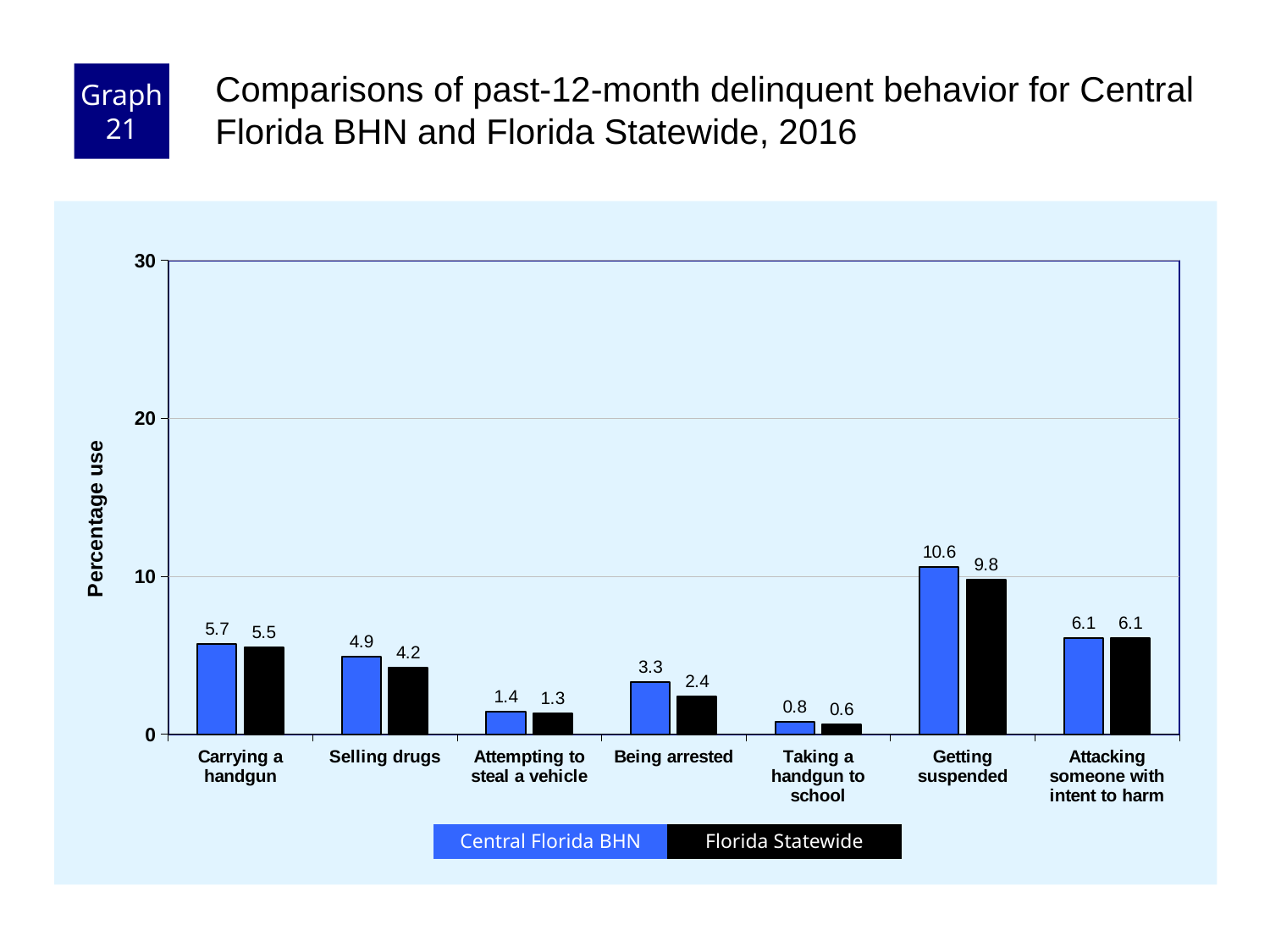
How many categories are shown on the x axis? 7 Which category has the highest Florida Statewide value? Getting suspended What is the Florida Statewide value for Being arrested? 2.4 How many series does the legend list? 2 What is the Central Florida BHN value for Taking a handgun to school? 0.8 Which category has the lowest Central Florida BHN value? Taking a handgun to school Which is larger for Being arrested: the Central Florida BHN value or the Florida Statewide value? Central Florida BHN Is the Central Florida BHN value for Getting suspended greater or less than 10? greater What is the label of the y axis? Percentage use What is the Central Florida BHN value for Getting suspended? 10.6 What kind of chart is shown on the slide? Bar chart What is the difference between the Central Florida BHN and Florida Statewide values for Selling drugs? 0.7